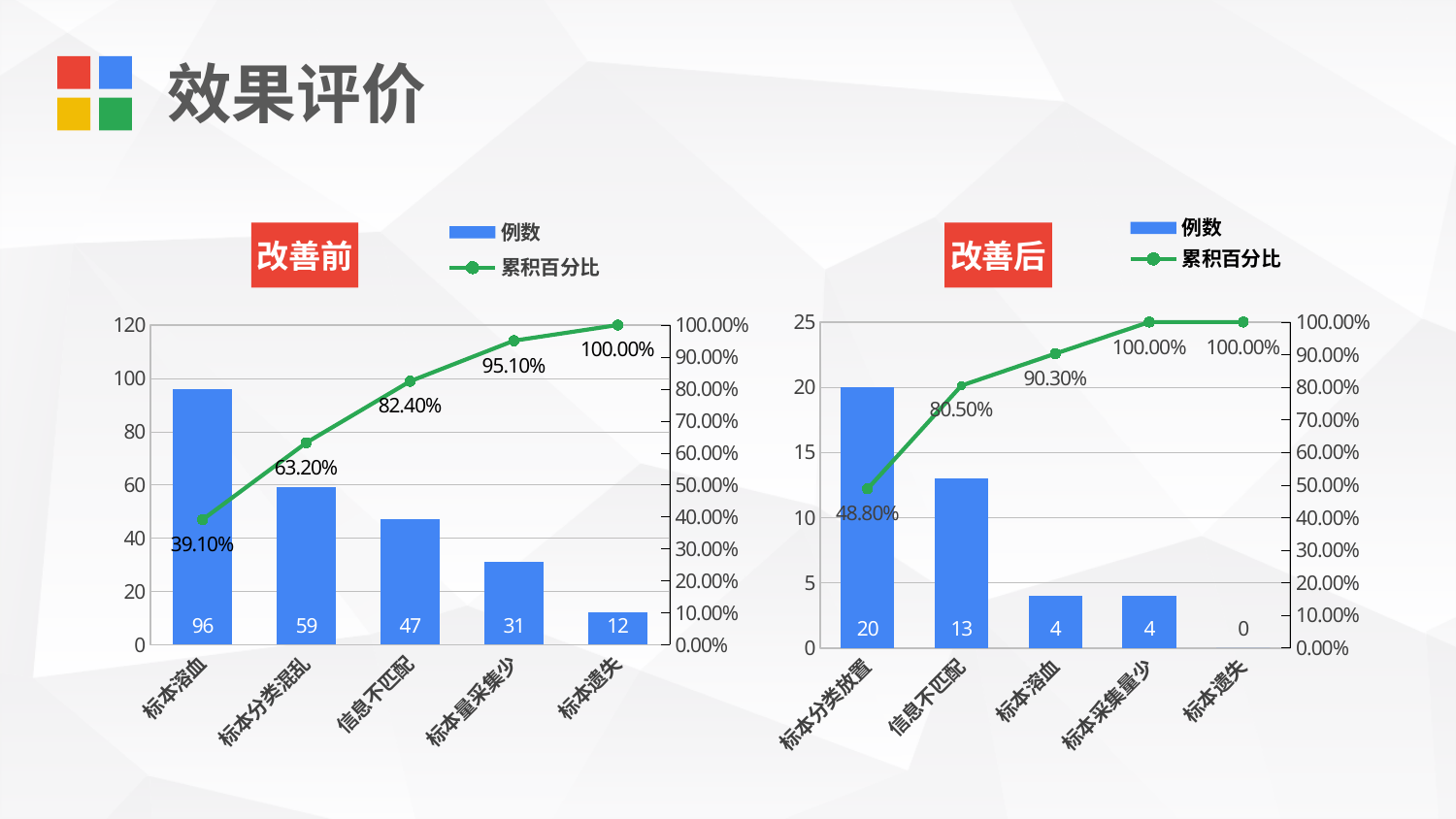
How many series does the legend of the 改善后 chart list? 2 In the 改善后 chart, what is the 例数 value for 标本遗失? 0 In the 改善前 chart, what is the 例数 value for 标本溶血? 96 In the 改善后 chart, what is the 例数 value for 信息不匹配? 13 In the 改善前 chart, how many categories are shown on the x axis? 5 In the 改善前 chart, which category has the lowest 例数? 标本遗失 Which is larger: the 例数 for 标本溶血 in the 改善前 chart or the 例数 for 标本分类放置 in the 改善后 chart? 标本溶血 in the 改善前 chart In the 改善后 chart, which category has the highest 例数? 标本分类放置 In the 改善后 chart, does the 累积百分比 line rise or fall from left to right? rise In the 改善后 chart, what is the 累积百分比 value at 标本分类放置? 48.80% In the 改善前 chart, what is the difference in 例数 between 标本溶血 and 标本分类混乱? 37 In the 改善前 chart, what is the 累积百分比 value at 信息不匹配? 82.40%